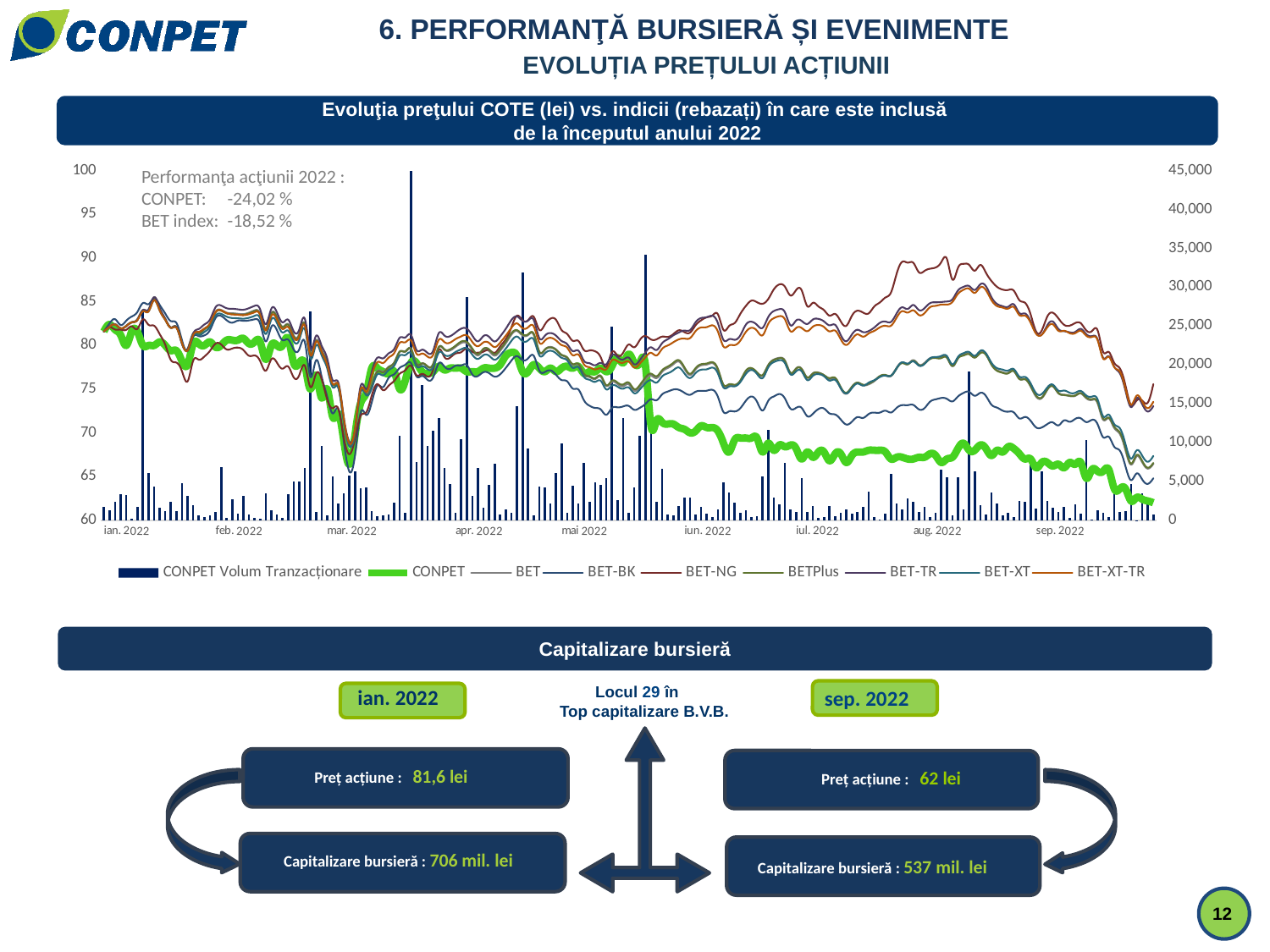
According to the annotation on the chart, what is the 2022 performance of CONPET? -24,02 % By how many percentage points does the 2022 performance of CONPET differ from that of the BET index, according to the chart annotation? 5,50 percentage points How many series does the legend of the chart list? 9 How many month labels are shown on the x axis of the chart? 9 What colour is the CONPET line in the chart? Green Is the CONPET value at the end of the chart (sep. 2022) greater or less than 65 on the left axis? less What kind of chart is shown on the slide? A combined line and bar chart Which fell more in 2022 according to the chart annotation, CONPET or the BET index? CONPET What is the title of the chart? Evoluţia preţului COTE (lei) vs. indicii (rebazați) în care este inclusă de la începutul anului 2022 According to the annotation on the chart, what is the 2022 performance of the BET index? -18,52 % Does the CONPET line rise or fall overall from ian. 2022 to sep. 2022? Fall Is the CONPET value at the start of the chart (ian. 2022) greater or less than 75 on the left axis? greater